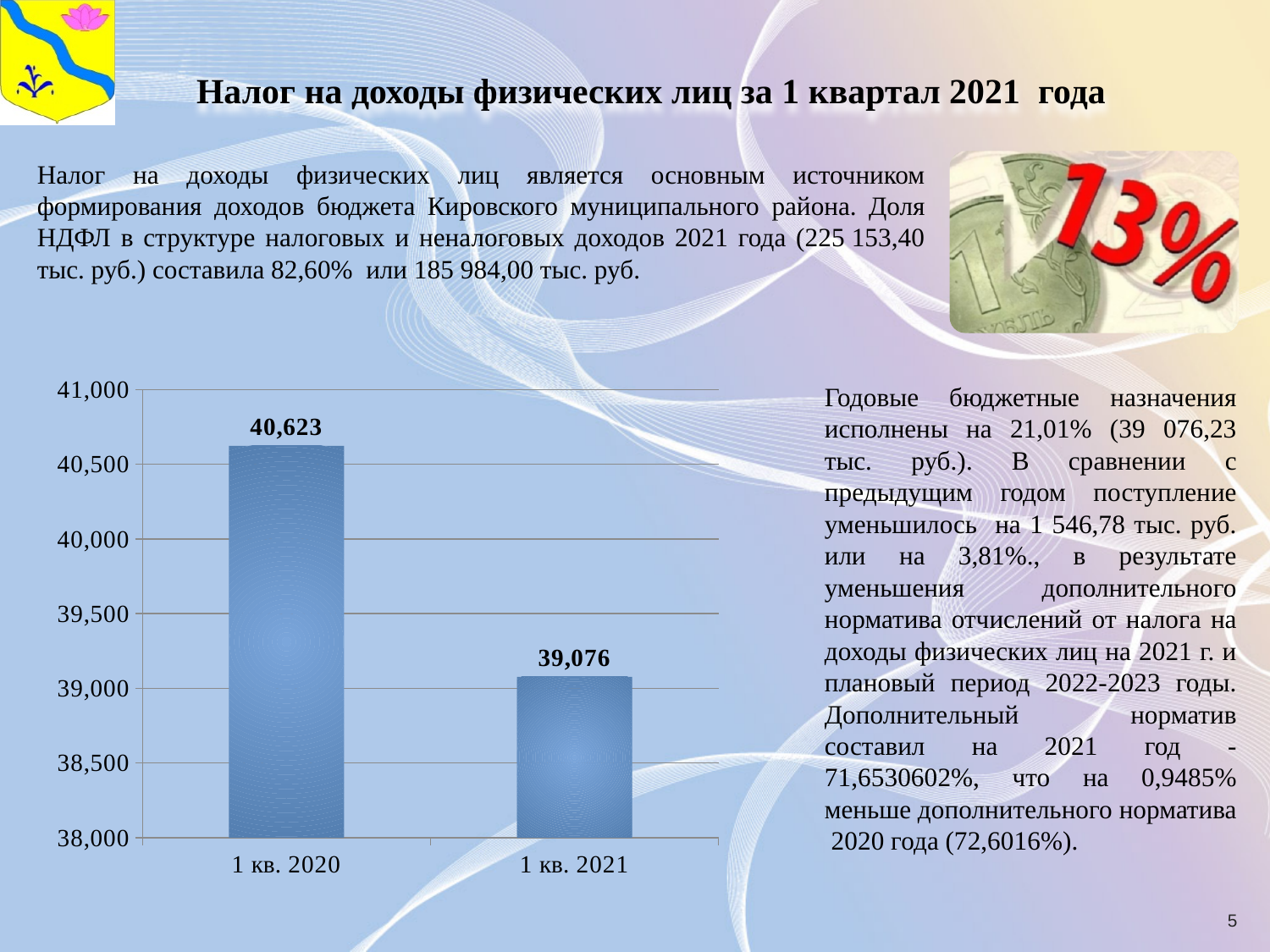
Which category has the lowest value? 1 кв. 2021 What is the value for 1 кв. 2021? 39,076 What is the value for 1 кв. 2020? 40,623 Is the value for 1 кв. 2021 greater or less than 39,500? less How many categories are shown on the x axis of the chart? 2 What is the difference between the values for 1 кв. 2020 and 1 кв. 2021? 1,547 What kind of chart is shown on the slide? bar chart Is the value for 1 кв. 2020 greater or less than 40,500? greater Which category has the highest value? 1 кв. 2020 Do the values rise or fall from 1 кв. 2020 to 1 кв. 2021? fall What is the highest tick value shown on the chart's vertical axis? 41,000 Which is larger, the value for 1 кв. 2020 or the value for 1 кв. 2021? 1 кв. 2020